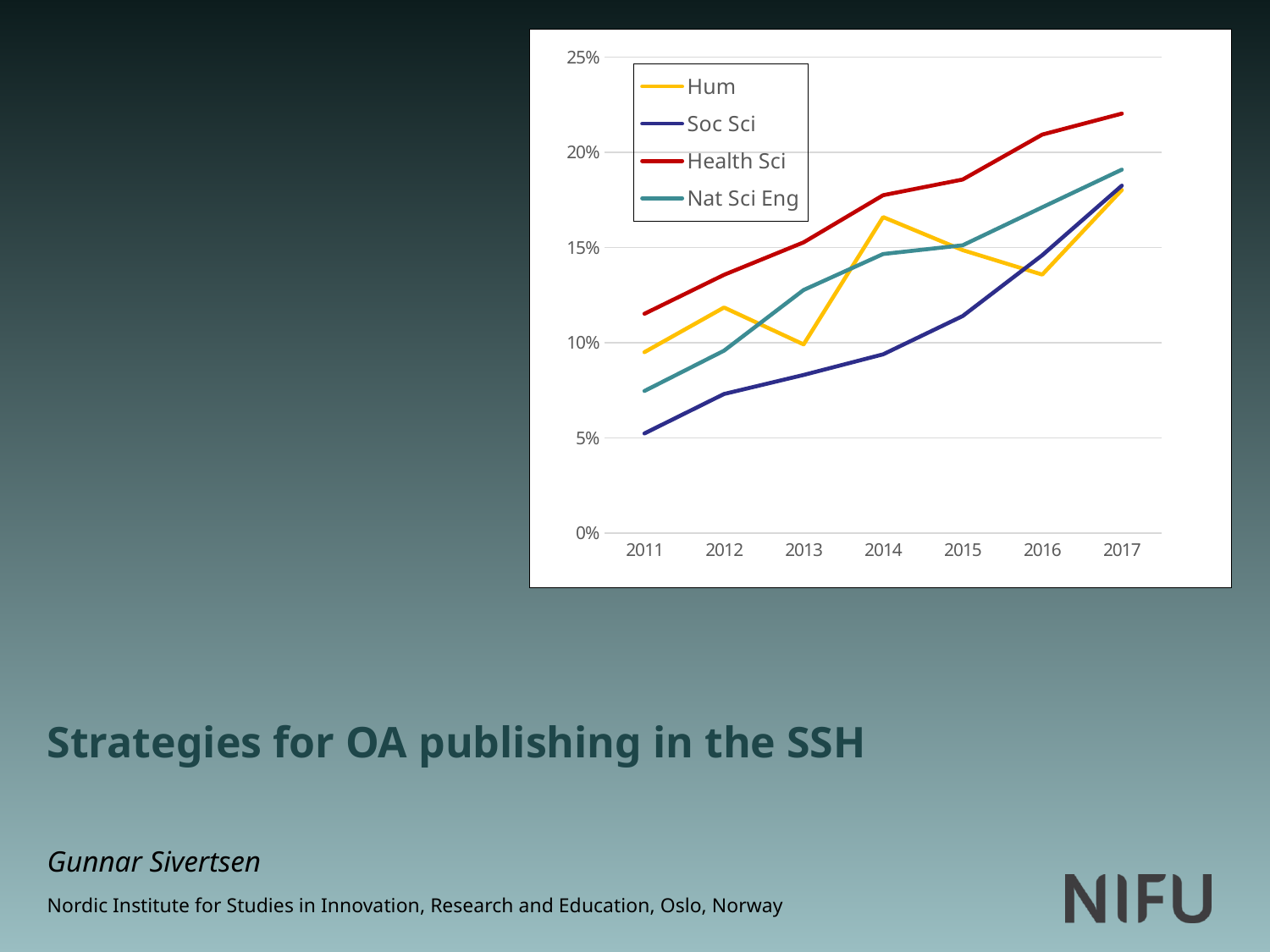
How many years are shown on the x axis? 7 What kind of chart is shown on the slide? line chart Does the Health Sci line rise or fall from 2011 to 2017? rise How many series does the legend list? 4 Is the value for Health Sci in 2017 greater or less than 20%? greater In 2013, which is larger, the value for Hum or the value for Soc Sci? Hum What colour is the Hum line in the legend? yellow Which series has the highest value in 2017? Health Sci Which series has the lowest value in 2011? Soc Sci Is the value for Soc Sci in 2011 greater or less than 10%? less Which series has the highest value in 2011? Health Sci Is the value for Hum in 2014 greater or less than 15%? greater